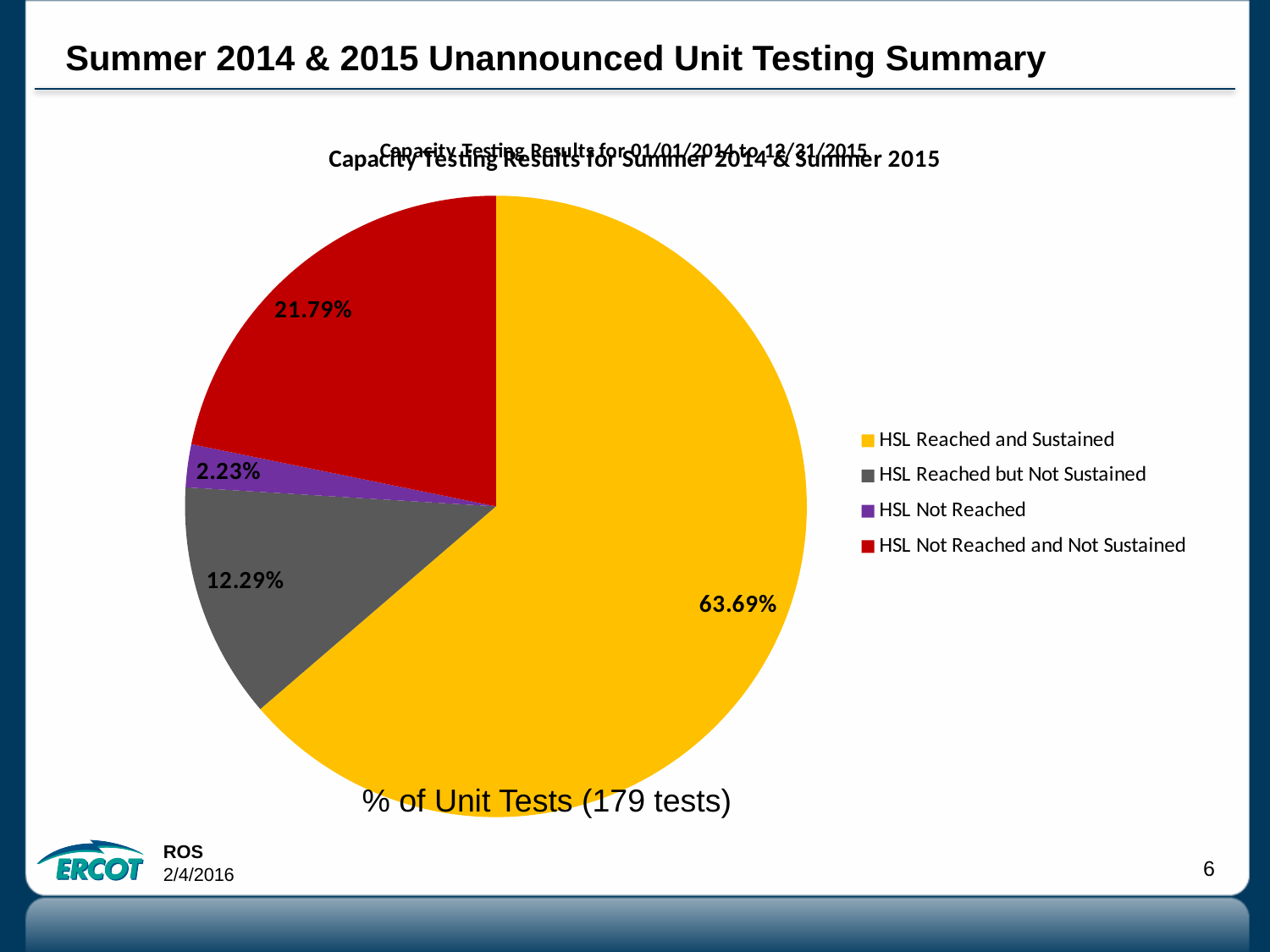
Which category has the largest share of the pie? HSL Reached and Sustained How many slices does the pie chart have? 4 Which is larger: the share for HSL Reached but Not Sustained or the share for HSL Not Reached and Not Sustained? HSL Not Reached and Not Sustained What percentage of unit tests had HSL Not Reached? 2.23% Which category has the smallest share of the pie? HSL Not Reached How many entries does the legend list? 4 What colour is the slice for HSL Not Reached? purple What percentage of unit tests had HSL Reached but Not Sustained? 12.29% What is the difference in percentage points between HSL Reached and Sustained and HSL Not Reached and Not Sustained? 41.90% What percentage of unit tests had HSL Reached and Sustained? 63.69% What type of chart is shown on the slide? pie chart What percentage of unit tests had HSL Not Reached and Not Sustained? 21.79%